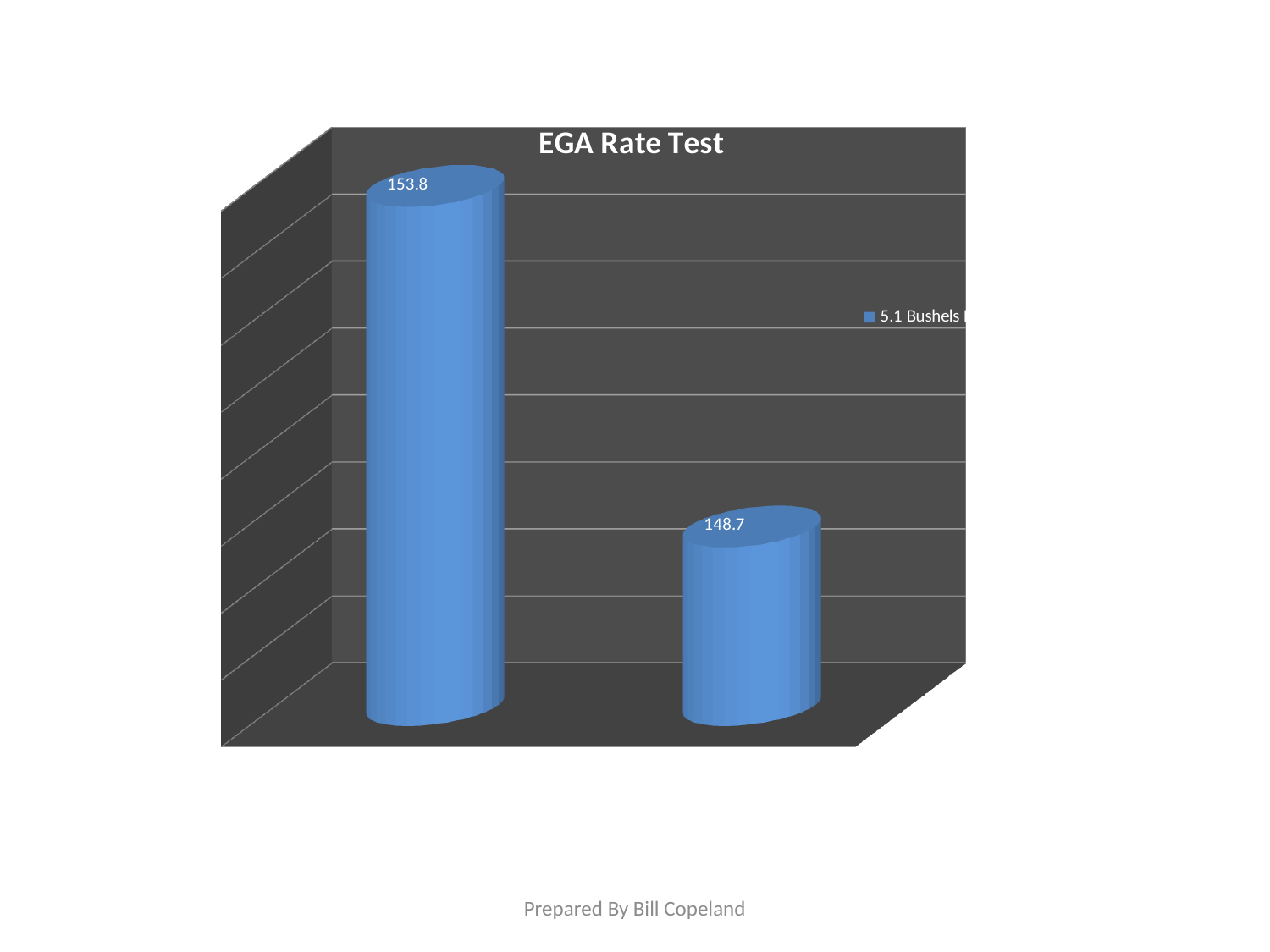
What is the difference between the left bar's value and the right bar's value? 5.1 What is the title of the chart? EGA Rate Test Do the values rise or fall from the left bar to the right bar? fall How many entries does the legend list? 1 What colour are the bars in the chart? blue What is the highest value shown in the chart? 153.8 What is the value shown on the left bar? 153.8 Which bar has the larger value, the left one or the right one? the left one What is the lowest value shown in the chart? 148.7 What is the value shown on the right bar? 148.7 How many bars are plotted in the chart? 2 What kind of chart is shown on the slide? bar chart